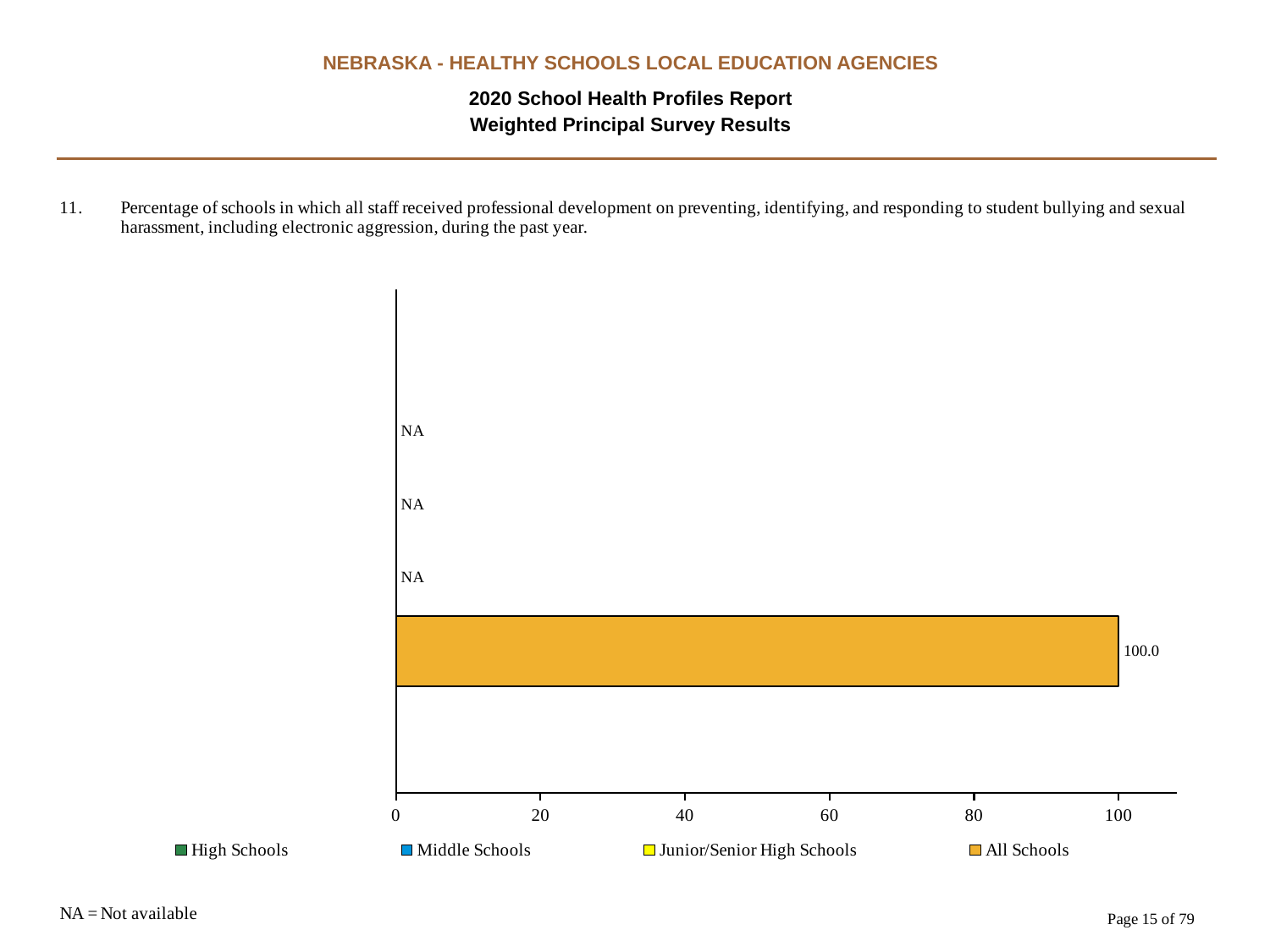
What is shown for High Schools? NA What is the highest value shown on the x axis? 100 What colour is the All Schools bar? Orange/yellow What is shown for Junior/Senior High Schools? NA How many series are marked NA? 3 How many series does the legend list? 4 Is the value for All Schools greater or less than 80? greater What kind of chart is shown? Bar chart What is the value for All Schools? 100.0 Which series is the only one with a plotted bar? All Schools What is shown for Middle Schools? NA